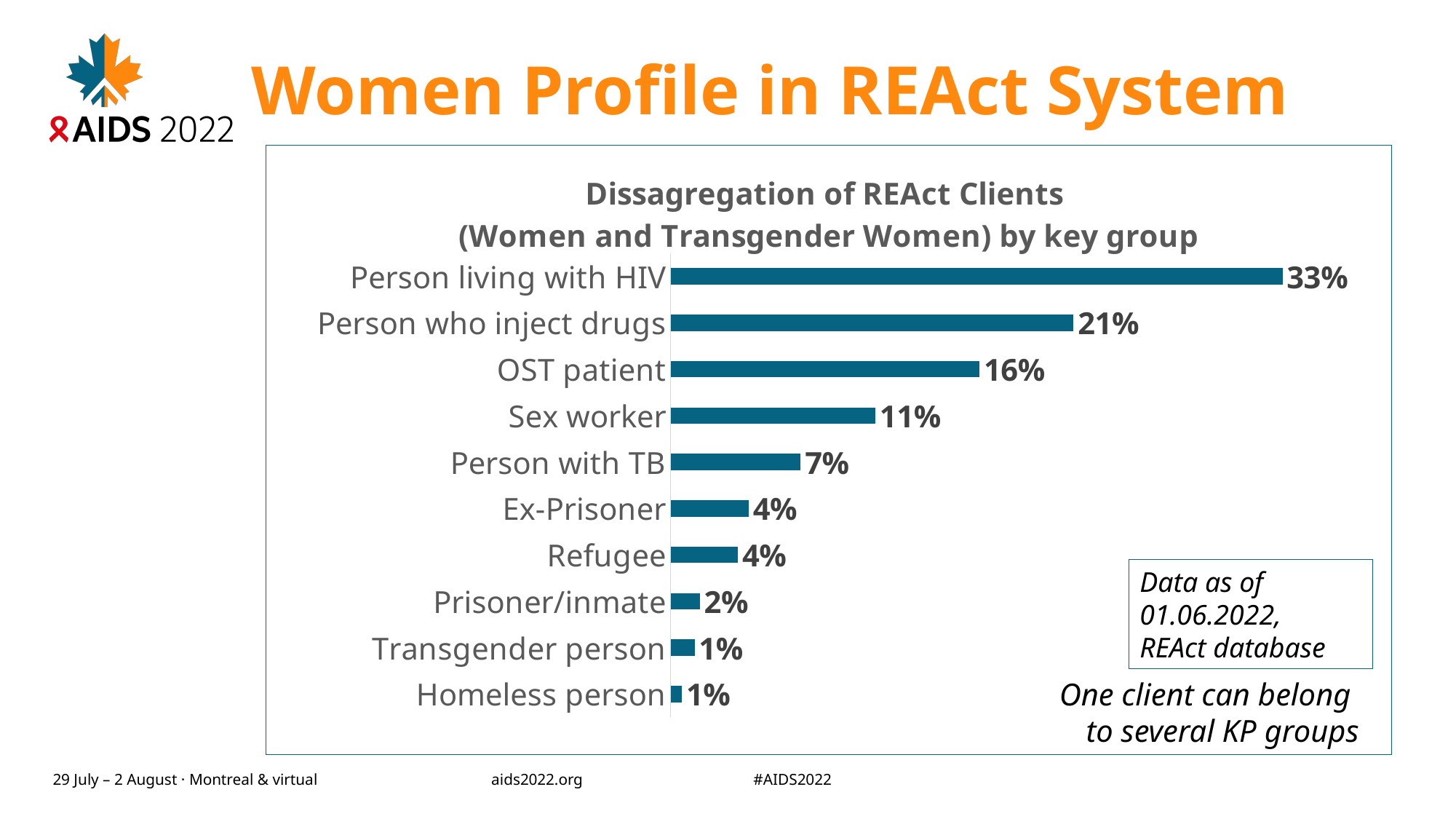
What percentage of REAct clients (women and transgender women) are persons living with HIV? 33% How many key groups are shown in the chart? 10 What is the title of the chart? Dissagregation of REAct Clients (Women and Transgender Women) by key group What is the value shown for OST patient? 16% Which key group has the highest percentage? Person living with HIV What is the difference between Person living with HIV and OST patient? 17% What is the value for Prisoner/inmate? 2% What is the difference between the values for Person who inject drugs and Person with TB? 14% Which is larger, the value for Sex worker or the value for Ex-Prisoner? Sex worker Which two key groups both have a value of 4%? Ex-Prisoner and Refugee What kind of chart is shown on the slide? Bar chart What percentage is shown for Sex worker? 11%